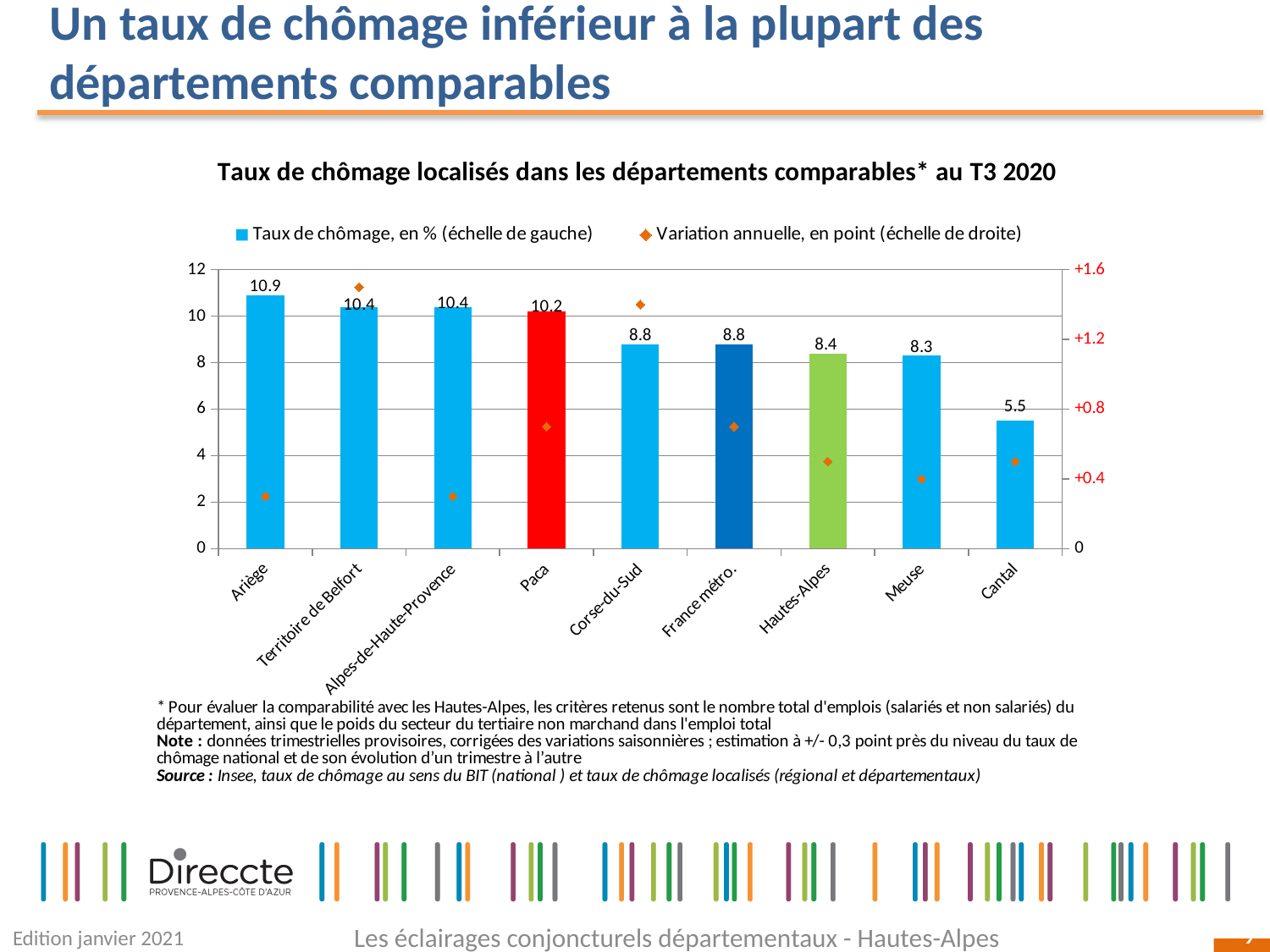
What is the unemployment rate shown for Cantal? 5.5 Is the annual variation (Variation annuelle) for Territoire de Belfort greater or less than +1.2 points? greater What is the difference between the unemployment rate of Ariège and that of Hautes-Alpes? 2.5 Is the annual variation for Ariège greater or less than +0.4 points? less Which has a higher unemployment rate, Paca or Meuse? Paca Which department has the highest unemployment rate on the chart? Ariège What is the unemployment rate shown for Hautes-Alpes? 8.4 How many departments or areas are shown on the x axis of the chart? 9 How many series does the chart legend list? 2 Which department has the lowest unemployment rate on the chart? Cantal What colour is the bar for Paca? Red What is the unemployment rate (taux de chômage) shown for Ariège? 10.9